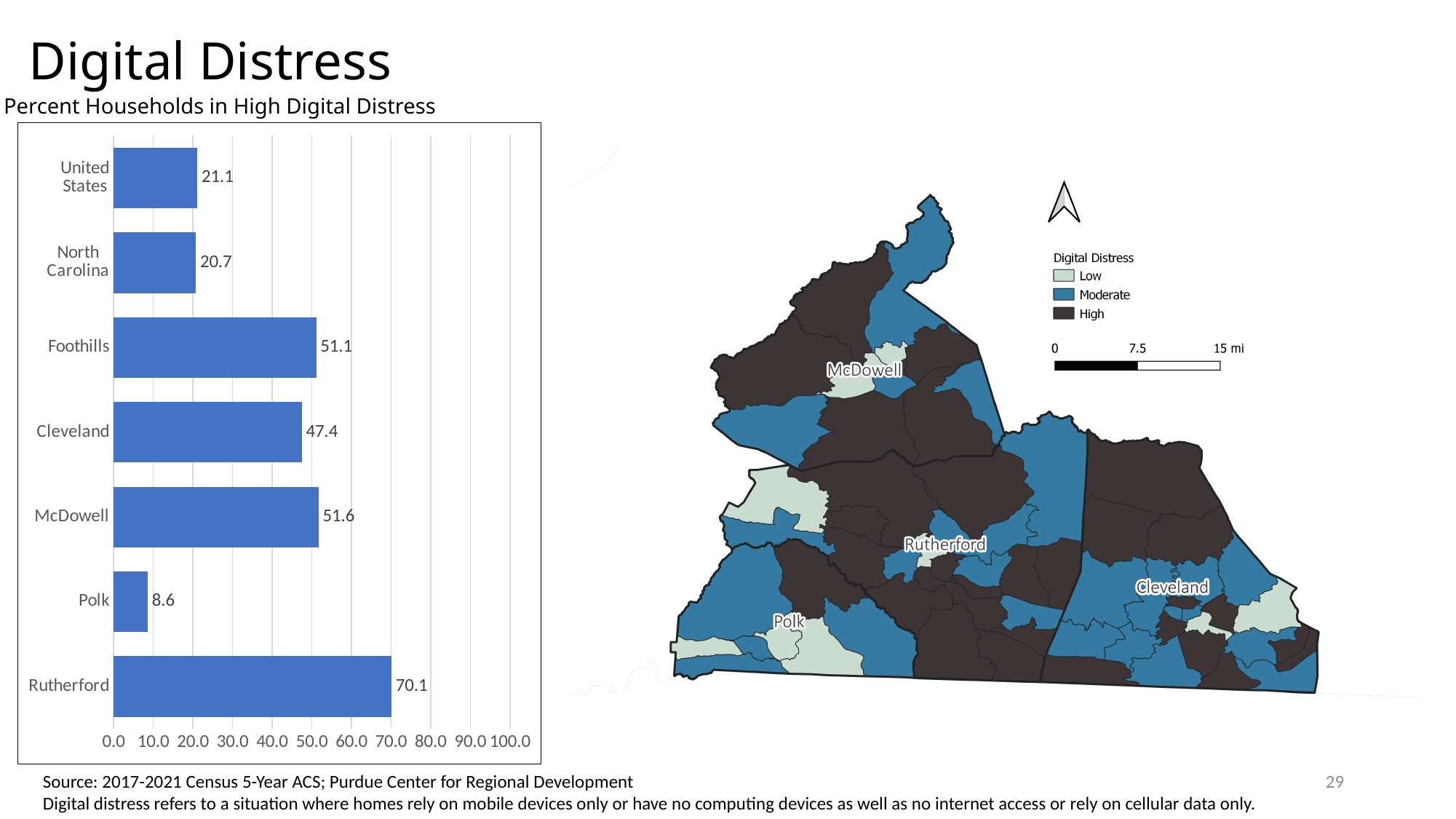
What is the value for North Carolina in the bar chart? 20.7 Which category has the highest value in the bar chart? Rutherford What is the value for Cleveland in the bar chart? 47.4 Which category has the lowest value in the bar chart? Polk What is the title of the bar chart? Percent Households in High Digital Distress What kind of chart is used to show Percent Households in High Digital Distress? Bar chart What is the difference between the values for McDowell and Foothills in the bar chart? 0.5 Which has a larger value in the bar chart, Foothills or Cleveland? Foothills What is the value for Rutherford in the bar chart? 70.1 What is the difference between the values for Rutherford and Polk in the bar chart? 61.5 How many categories are shown in the bar chart? 7 Is the value for Cleveland in the bar chart greater or less than 50.0? less